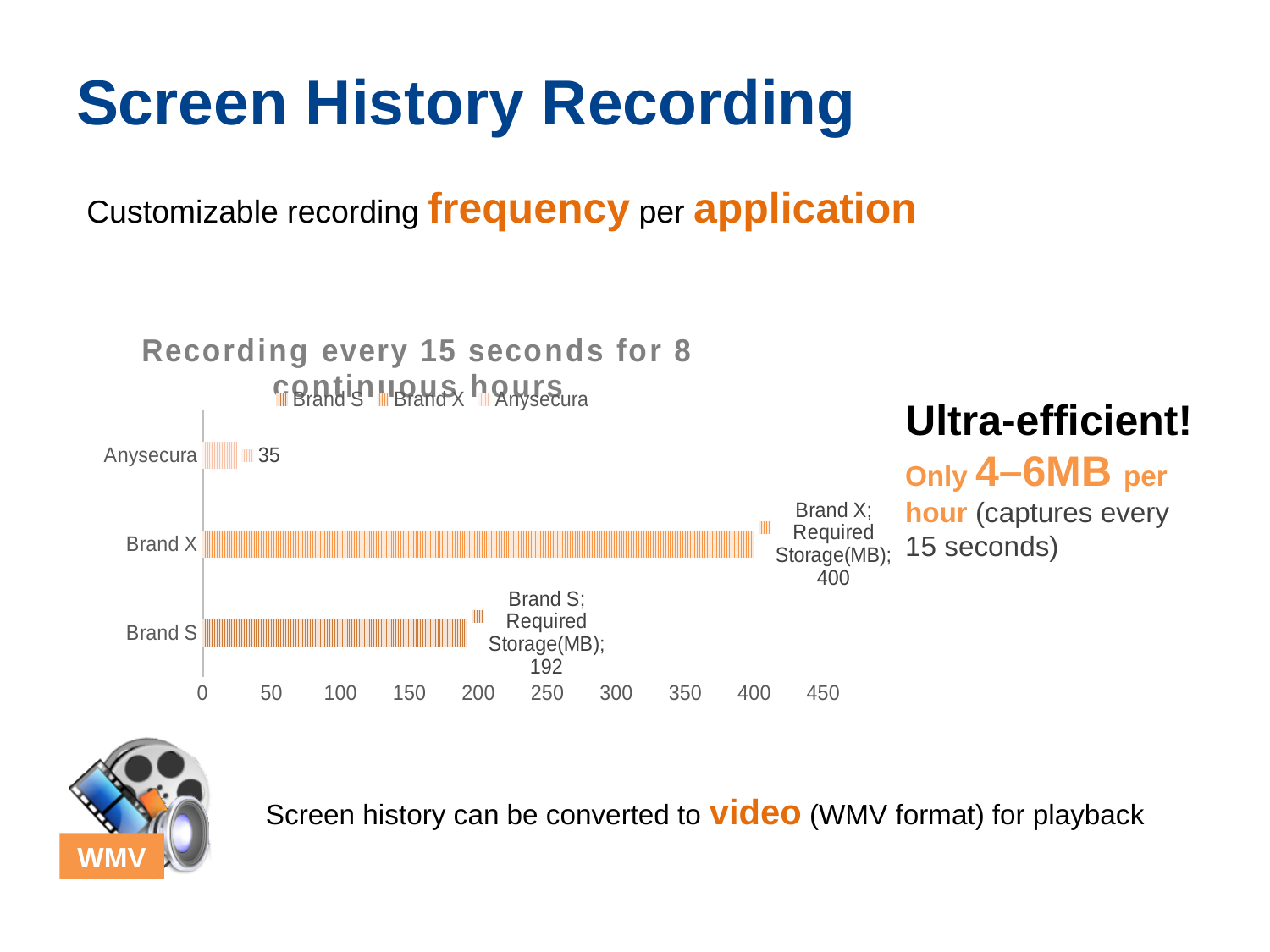
What is the difference between the values for Brand X and Brand S? 208 What is the required storage value shown for Brand S? 192 Which category has the highest required storage? Brand X What kind of chart is shown on the slide? bar chart How many entries does the legend list? 3 What value is shown for Anysecura? 35 How many categories are plotted on the chart? 3 What is the title of the chart? Recording every 15 seconds for 8 continuous hours What is the difference between the values for Brand S and Anysecura? 157 Which is larger, the value for Brand S or the value for Anysecura? Brand S What is the required storage value shown for Brand X? 400 Which category has the lowest required storage? Anysecura